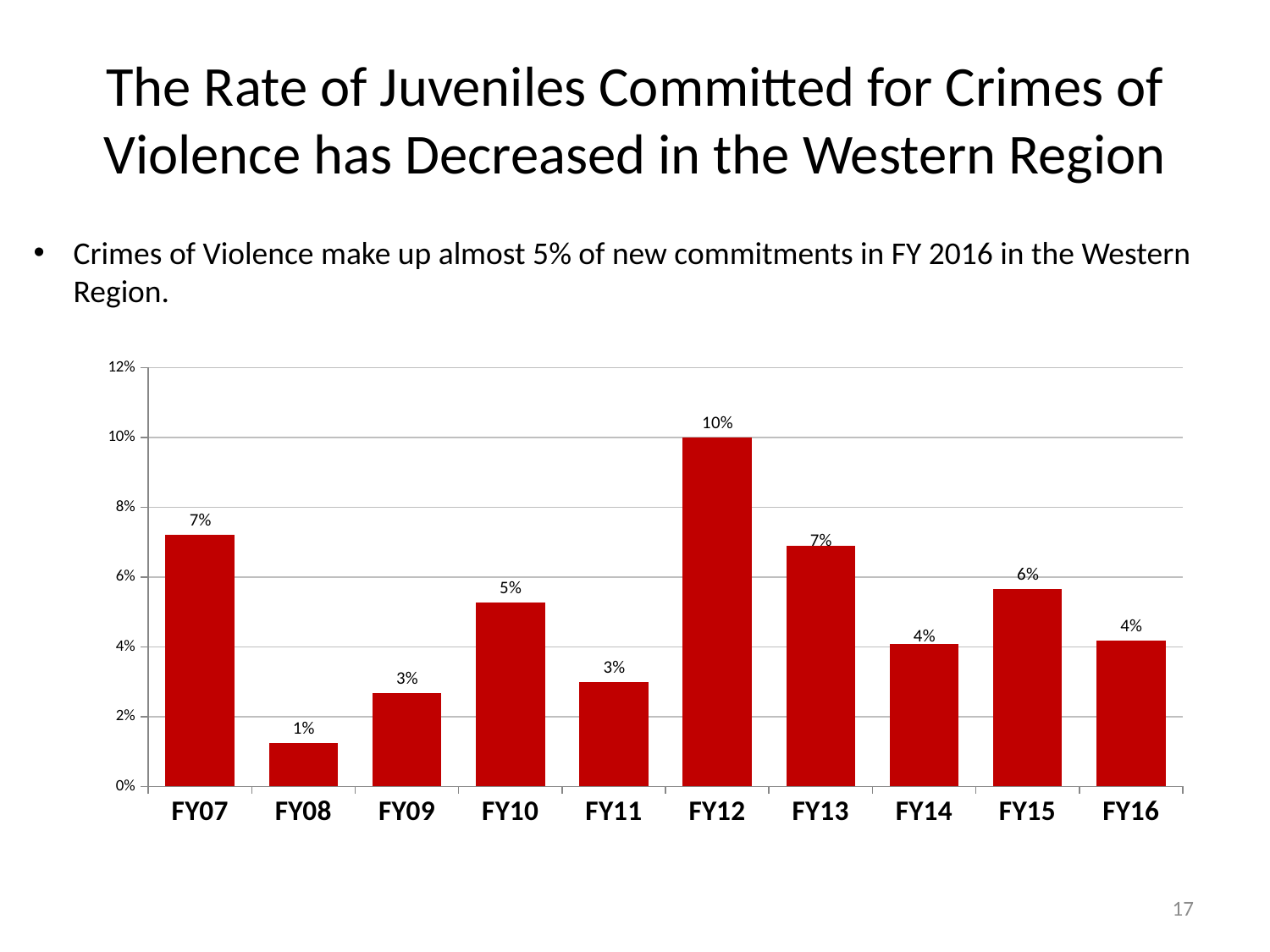
What is the difference between the values for FY12 and FY08? 9% What is the value for FY08? 1% What is the value for FY16? 4% Which fiscal year has the highest value? FY12 Do the values rise or fall from FY08 to FY10? rise What is the value for FY12? 10% Which is larger, the value for FY10 or the value for FY11? FY10 What kind of chart is shown on the slide? bar chart Is the value for FY09 greater or less than 4%? less What is the value for FY10? 5% How many fiscal years are shown on the x axis? 10 Which fiscal year has the lowest value? FY08